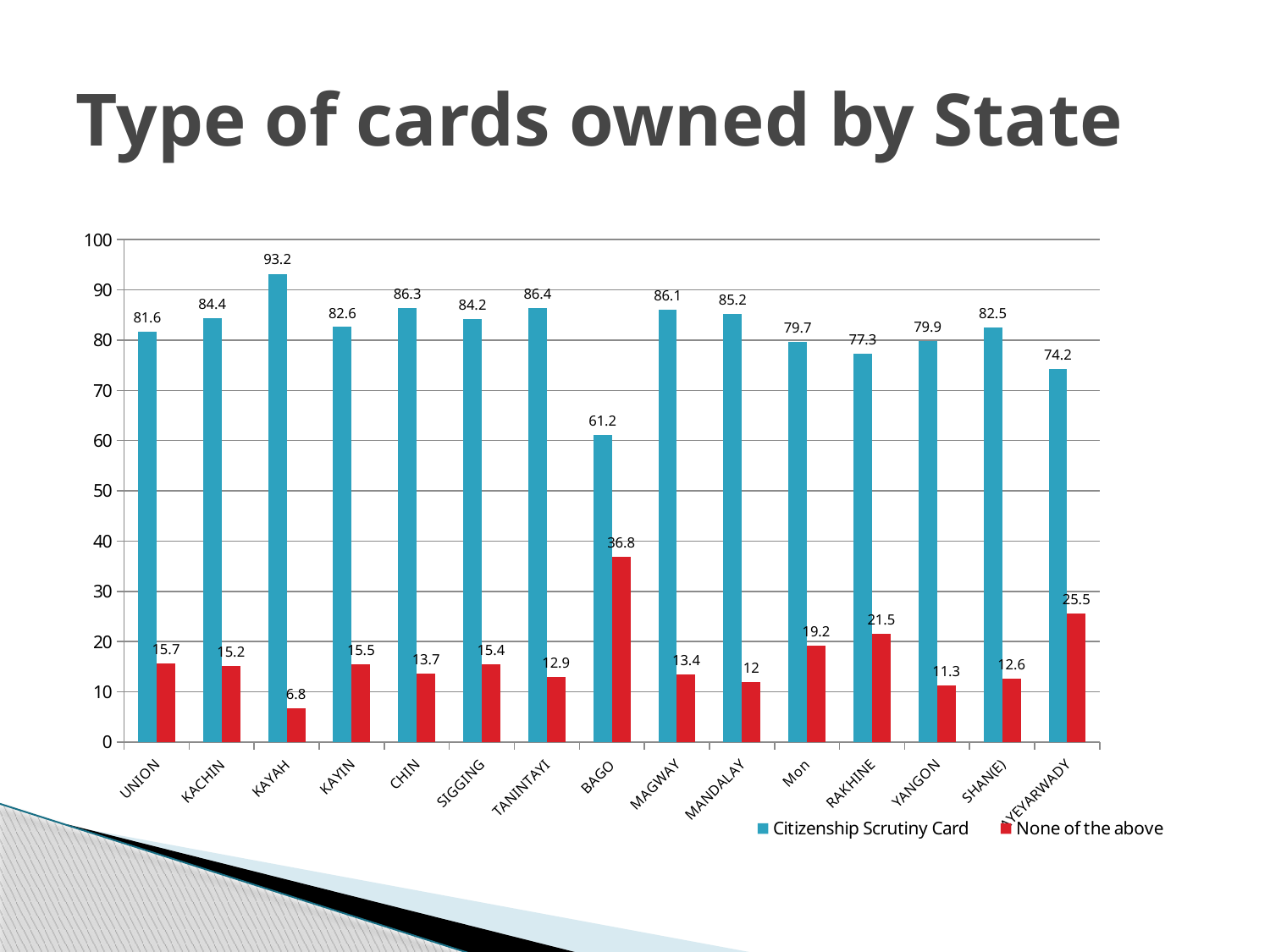
What is the Citizenship Scrutiny Card value for AYEYARWADY? 74.2 Which state has the lowest Citizenship Scrutiny Card value? BAGO Is the Citizenship Scrutiny Card value for BAGO greater or less than 70? less How many series does the legend list? 2 Which is larger, the None of the above value for RAKHINE or for Mon? RAKHINE What is the None of the above value for BAGO? 36.8 What type of chart is shown on the slide? bar chart How many states are shown on the x axis? 15 Which state has the lowest None of the above value? KAYAH Which state has the highest Citizenship Scrutiny Card value? KAYAH What is the difference between the Citizenship Scrutiny Card value and the None of the above value for BAGO? 24.4 What is the Citizenship Scrutiny Card value for KAYAH? 93.2